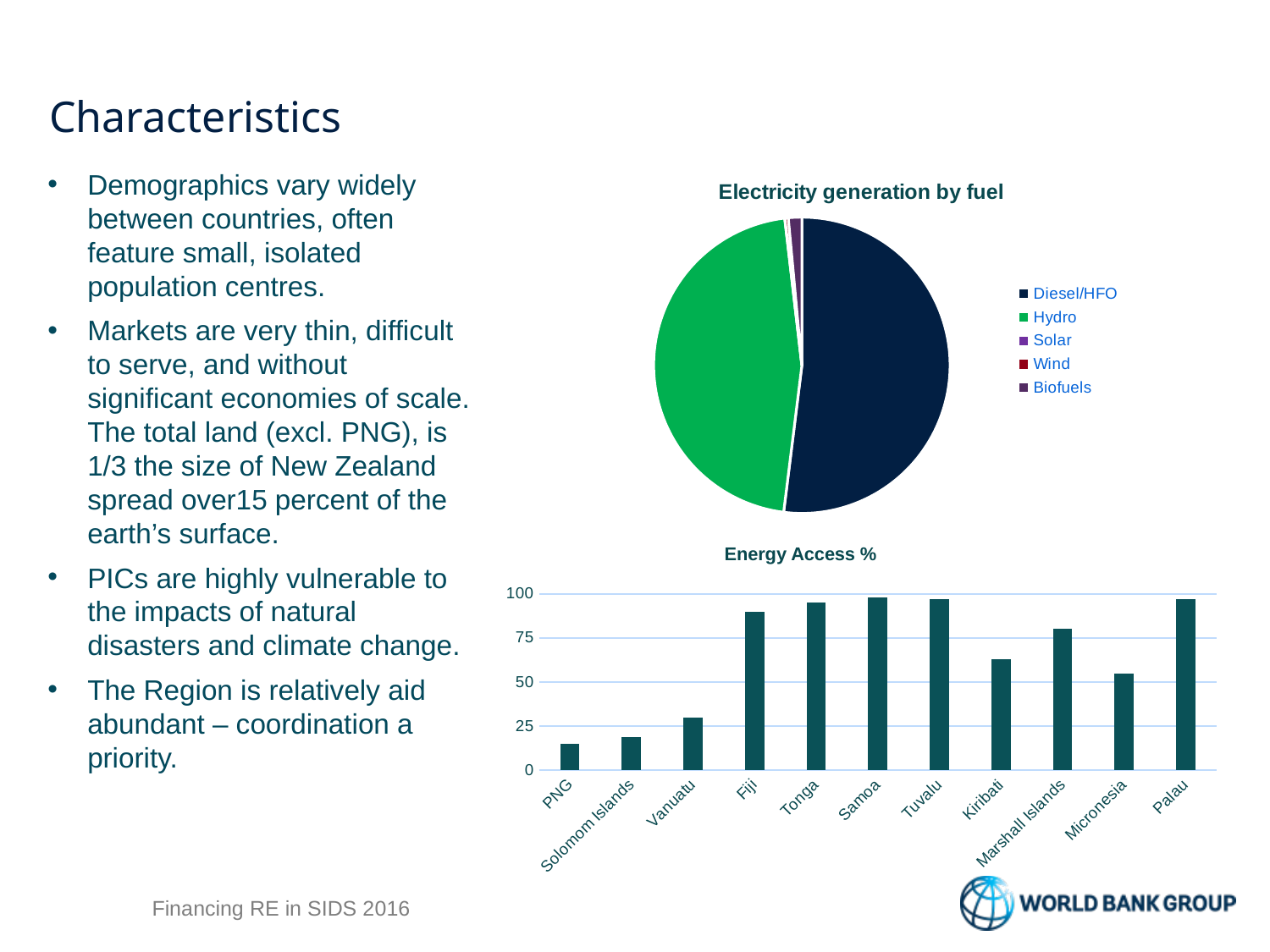
In the 'Electricity generation by fuel' chart, which fuel has the largest slice? Diesel/HFO What kind of chart is the 'Energy Access %' chart? bar chart In the 'Energy Access %' chart, is the value for Vanuatu greater or less than 25? greater In the 'Energy Access %' chart, which country has the lowest value? PNG In the 'Energy Access %' chart, is the value for Kiribati greater or less than 75? less In the 'Energy Access %' chart, which country has the higher value, Fiji or Micronesia? Fiji In the 'Energy Access %' chart, is the value for PNG greater or less than 25? less How many countries are shown in the 'Energy Access %' chart? 11 In the 'Electricity generation by fuel' chart, which slice is larger, Hydro or Solar? Hydro How many fuel types does the legend of the 'Electricity generation by fuel' chart list? 5 What kind of chart is the 'Electricity generation by fuel' chart? pie chart